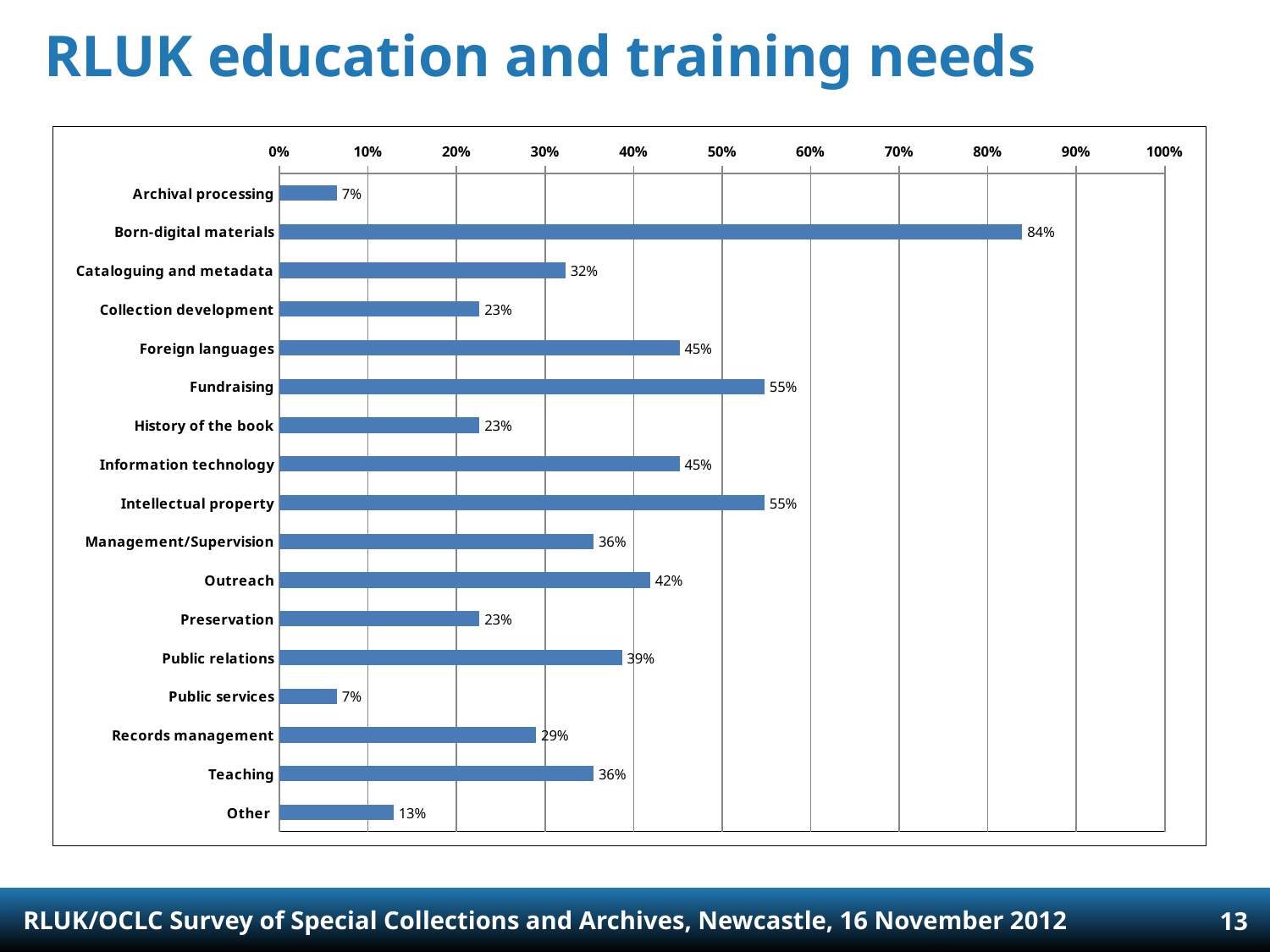
What kind of chart is shown on the slide? Bar chart What is the value for Other? 13% Which category has the highest value? Born-digital materials What is the value for Records management? 29% What is the value for Born-digital materials? 84% What is the difference between the values for Outreach and Public relations? 3% Which is larger, the value for Cataloguing and metadata or the value for Management/Supervision? Management/Supervision How many categories are shown on the chart? 17 What is the value for Fundraising? 55% Which is larger, the value for Foreign languages or the value for Collection development? Foreign languages What is the difference between the values for Born-digital materials and Fundraising? 29% What is the title of the slide containing the chart? RLUK education and training needs